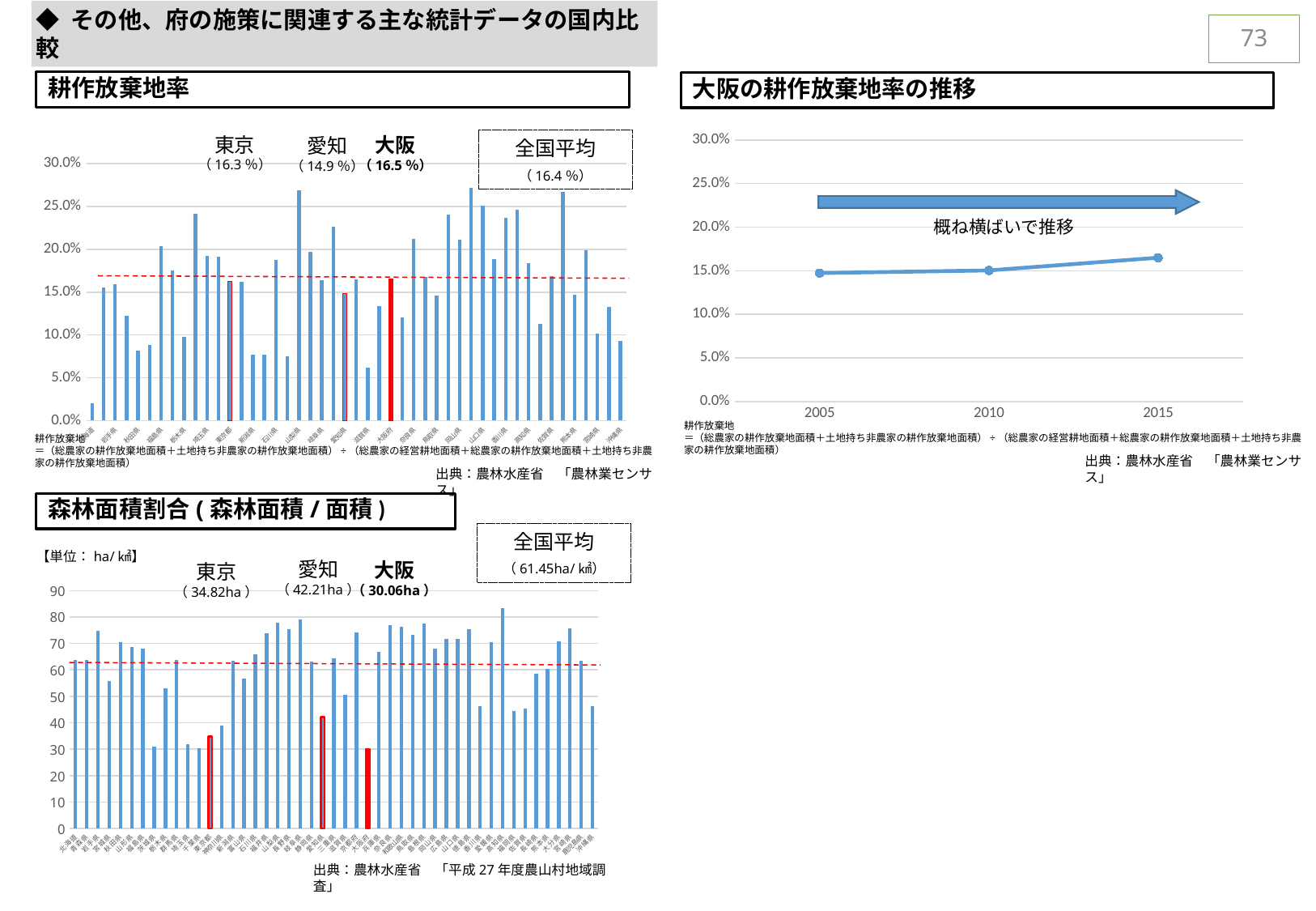
In the 森林面積割合 chart (bottom left), which has the higher printed value, 東京 or 愛知? 愛知 What kind of chart is the 耕作放棄地率 chart (top left)? bar chart In the 森林面積割合 chart (bottom left), what is the 全国平均 value shown in the box? 61.45ha/㎢ In the 森林面積割合 chart (bottom left), what is the value printed for 大阪? 30.06ha In the 耕作放棄地率 chart (top left), what is the value printed for 東京? 16.3% In the 耕作放棄地率 chart (top left), what is the difference between the printed values for 大阪 and 愛知? 1.6% In the 耕作放棄地率 chart (top left), which has the higher printed value, 大阪 or 東京? 大阪 In the 森林面積割合 chart (bottom left), what is the difference between the printed values for 愛知 and 大阪? 12.15ha In the 耕作放棄地率 chart (top left), what is the 全国平均 value shown in the box? 16.4% In the 耕作放棄地率 chart (top left), what is the value printed for 大阪? 16.5% In the 大阪の耕作放棄地率の推移 chart (right), how many data points are plotted? 3 In the 大阪の耕作放棄地率の推移 chart (right), is the value for 2015 greater or less than 15.0%? greater